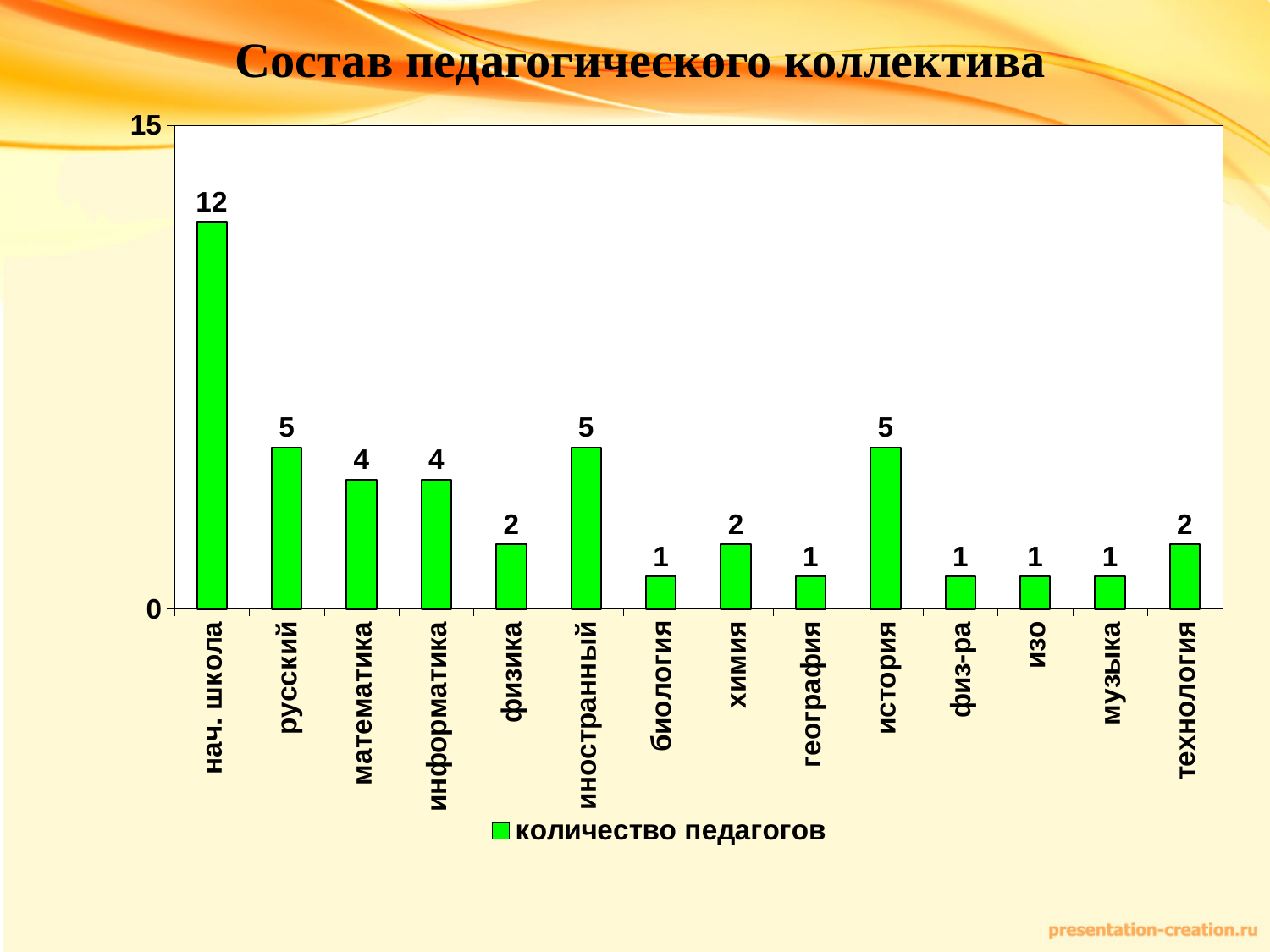
What is the legend entry for the series? количество педагогов What kind of chart is shown on the slide? bar chart What is the value for нач. школа? 12 Which category has the highest value? нач. школа How many series does the legend list? 1 Which is larger, the value for математика or the value for химия? математика What is the title of the chart? Состав педагогического коллектива What is the value for физика? 2 What is the value for иностранный? 5 What is the difference between the values for история and технология? 3 What is the difference between the values for нач. школа and русский? 7 How many categories are shown on the x axis? 14